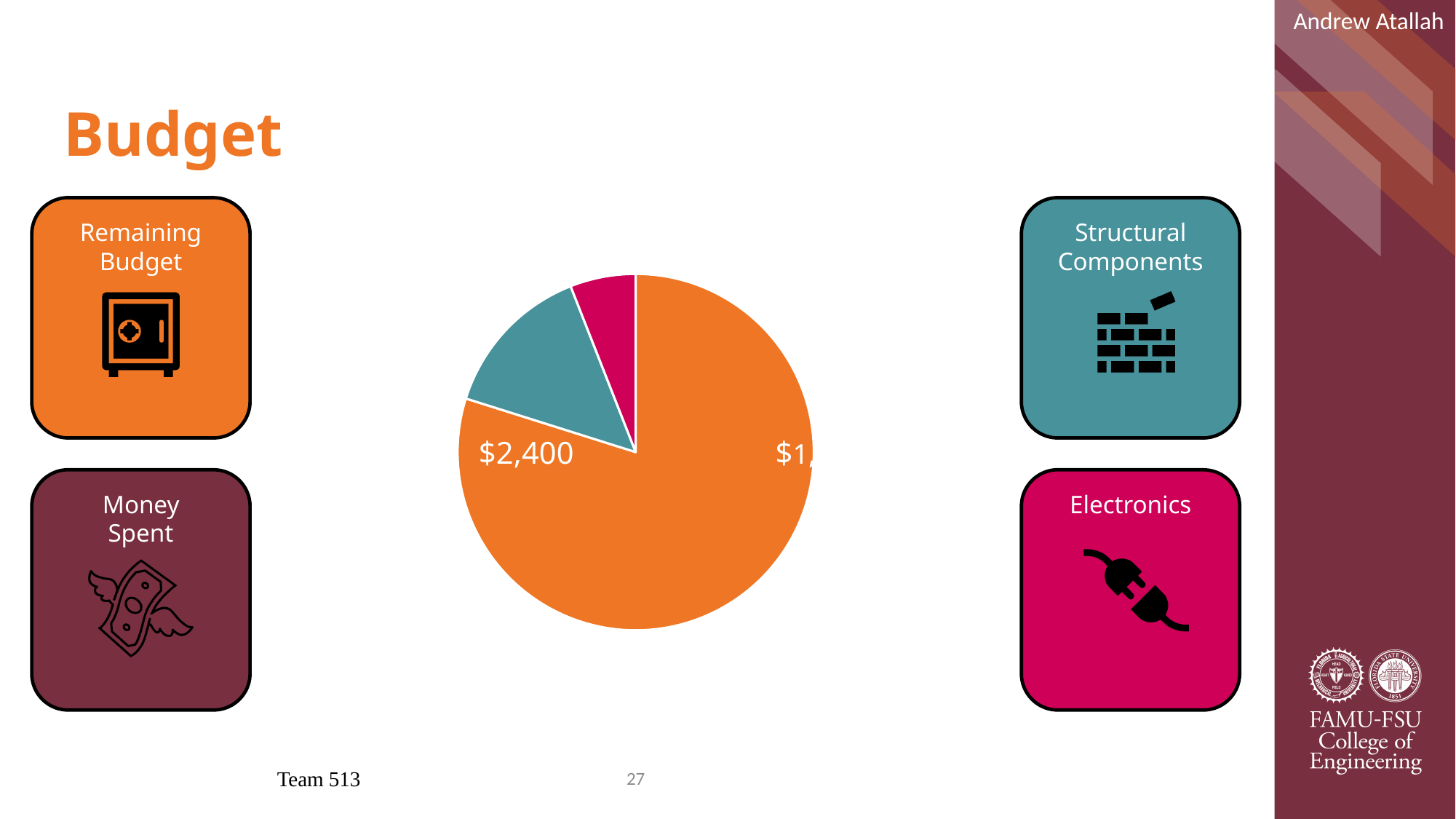
What is the title of the slide containing the pie chart? Budget Which colour slice is the smallest in the pie chart? magenta What kind of chart is shown on the Budget slide? pie chart Which category box on the slide matches the colour of the largest pie slice? Remaining Budget Does the orange slice take up more or less than half of the pie chart? more Which slice is larger in the pie chart, the orange slice or the teal slice? orange Which colour slice is the largest in the pie chart? orange Which slice is larger in the pie chart, the teal slice or the magenta slice? teal How many slices does the pie chart have? 3